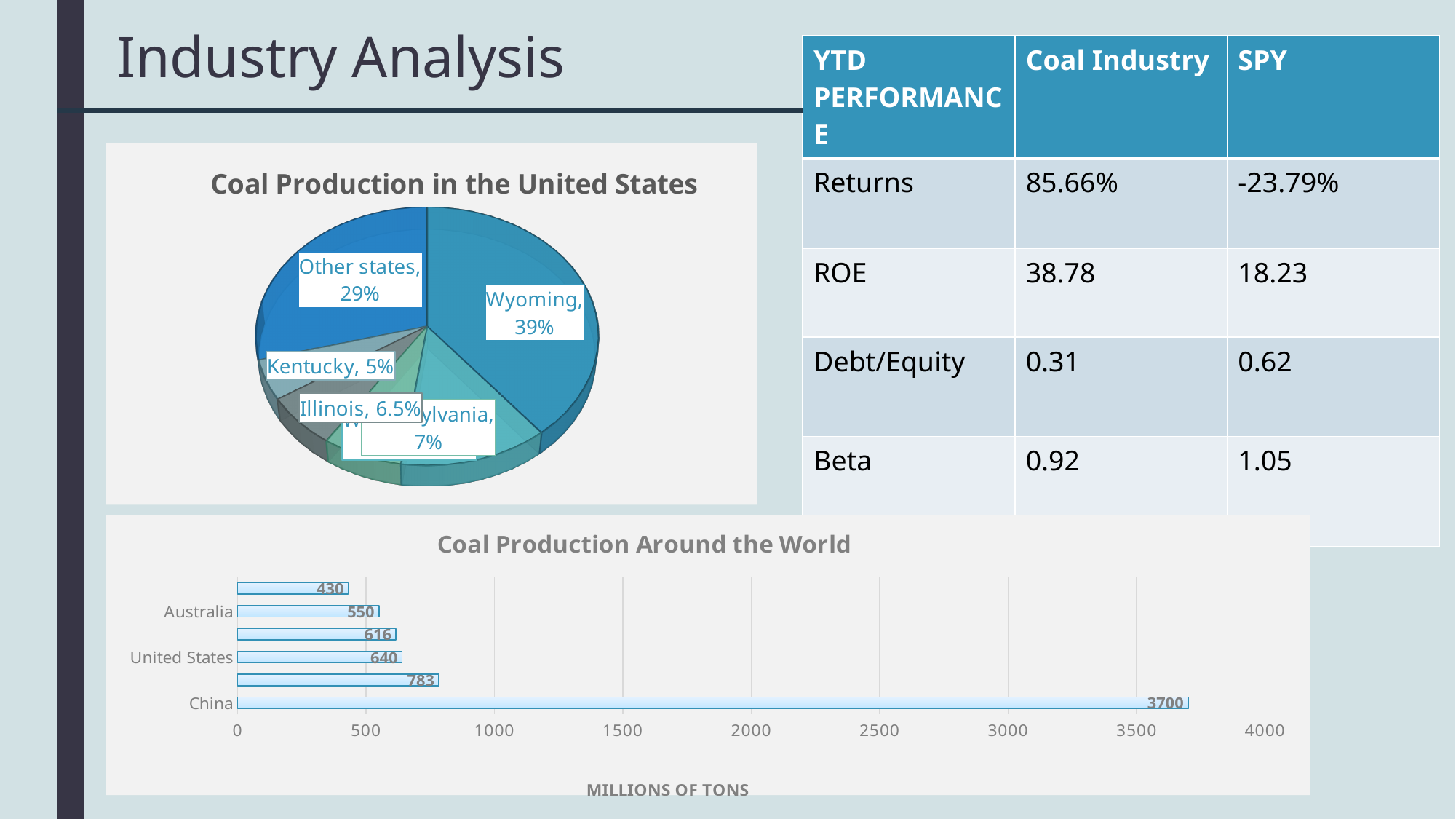
What kind of chart is 'Coal Production in the United States'? Pie chart In the 'Coal Production in the United States' pie chart, which labelled state has the largest share? Wyoming In the 'Coal Production Around the World' chart, what is the difference between China's value and the United States' value? 3060 In the 'Coal Production Around the World' chart, what is the value for Australia? 550 In the 'Coal Production in the United States' pie chart, what share does Kentucky have? 5% In the 'Coal Production in the United States' pie chart, what share does Illinois have? 6.5% In the 'Coal Production in the United States' pie chart, what share does Wyoming have? 39% In the 'Coal Production in the United States' pie chart, which is larger, the share for Illinois or the share for Kentucky? Illinois In the 'Coal Production Around the World' chart, what is the value for the United States? 640 In the 'Coal Production in the United States' pie chart, what share is labelled for Other states? 29% In the 'Coal Production Around the World' chart, what is the value for China? 3700 In the 'Coal Production in the United States' pie chart, how many percentage points larger is Wyoming's share than the Other states share? 10